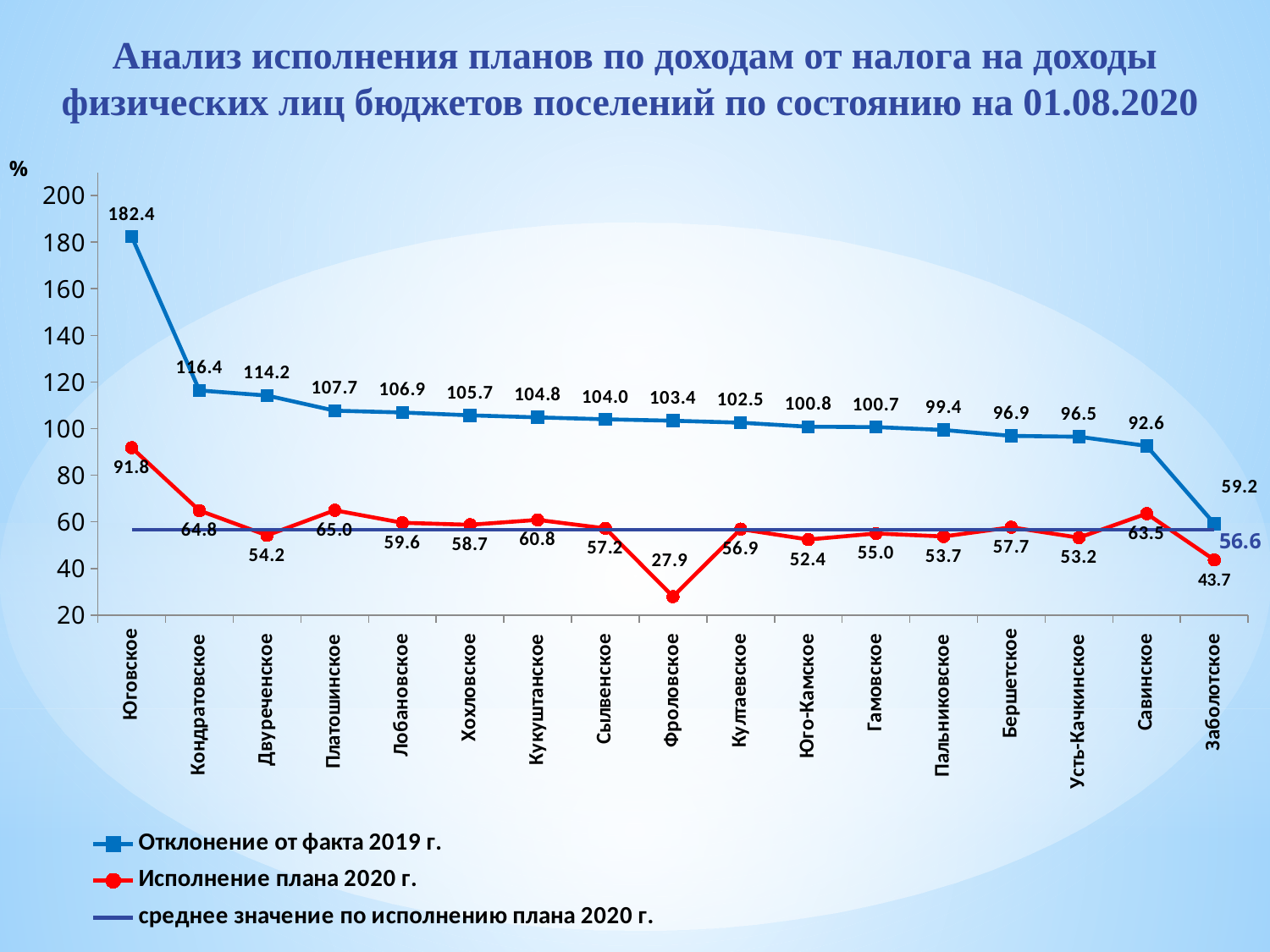
What kind of chart is shown on the slide? Line chart What is the value of the 'Исполнение плана 2020 г.' series for Фроловское? 27.9 What value does the line 'среднее значение по исполнению плана 2020 г.' show? 56.6 What is the difference between the 'Отклонение от факта 2019 г.' values for Кондратовское and Двуреченское? 2.2 How many settlements are shown on the x axis? 17 How many series does the legend list? 3 Which settlement has the lowest value in the 'Исполнение плана 2020 г.' series? Фроловское In the 'Исполнение плана 2020 г.' series, which is larger: Савинское or Заболотское? Савинское Which settlement has the lowest value in the 'Отклонение от факта 2019 г.' series? Заболотское What is the value of the 'Отклонение от факта 2019 г.' series for Заболотское? 59.2 What is the value of the 'Отклонение от факта 2019 г.' series for Юговское? 182.4 Which settlement has the highest value in the 'Исполнение плана 2020 г.' series? Юговское